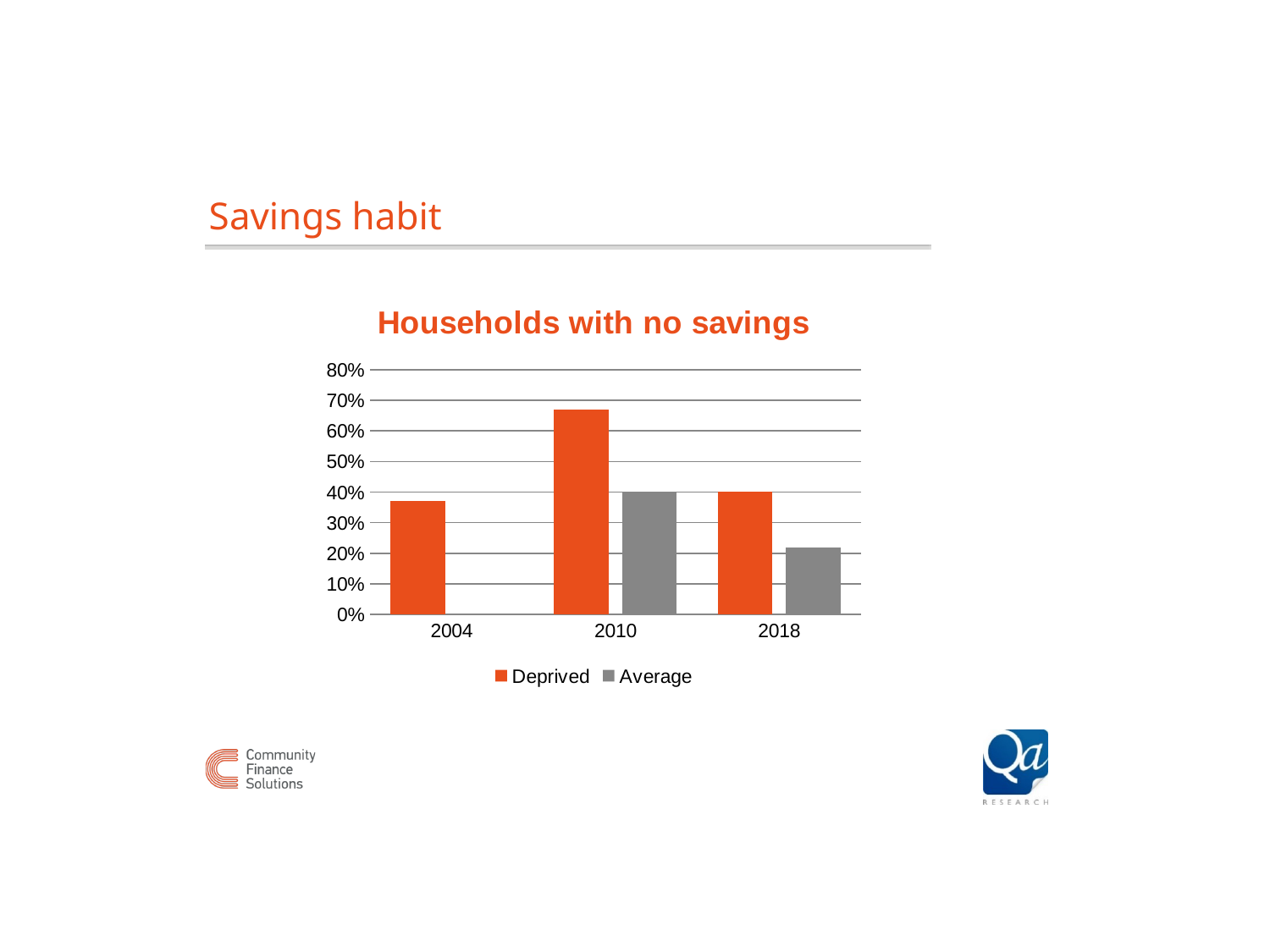
How many years are shown on the x axis? 3 How many series does the legend list? 2 What kind of chart is shown on the slide? bar chart Does the Average value rise or fall from 2010 to 2018? fall In which year is the Deprived value highest? 2010 Is the Deprived value for 2010 greater or less than 60%? greater Is the Average value for 2018 greater or less than 30%? less In which year is the Deprived value lowest? 2004 Which colour represents the Deprived series? orange In 2010, which is larger, the Deprived value or the Average value? Deprived Is the Deprived value for 2004 greater or less than 40%? less What is the title of the chart? Households with no savings